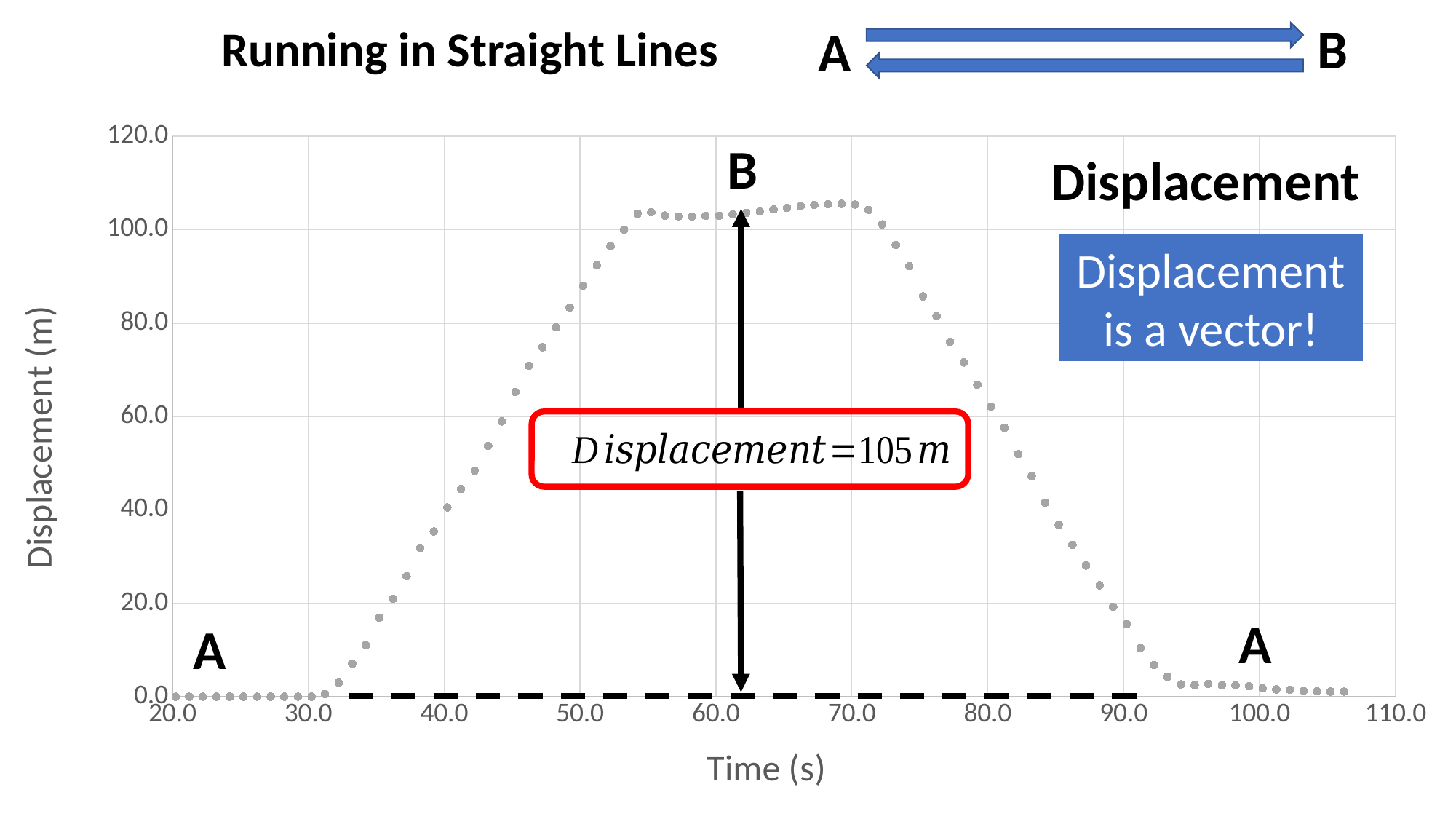
What is the label of the y axis? Displacement (m) What is the title of the chart? Running in Straight Lines Is the displacement at time 30.0 s greater or less than 20? less What kind of chart is shown on the slide? scatter plot Is the displacement at time 90.0 s greater or less than 20? less Which of the two labelled positions, A or B, has the higher displacement? B Is the displacement at time 55.0 s greater or less than 80? greater Do the plotted values rise or fall between time 35.0 s and 55.0 s? rise What displacement value is stated in the red box on the chart? 105 m Do the plotted values rise or fall between time 75.0 s and 90.0 s? fall